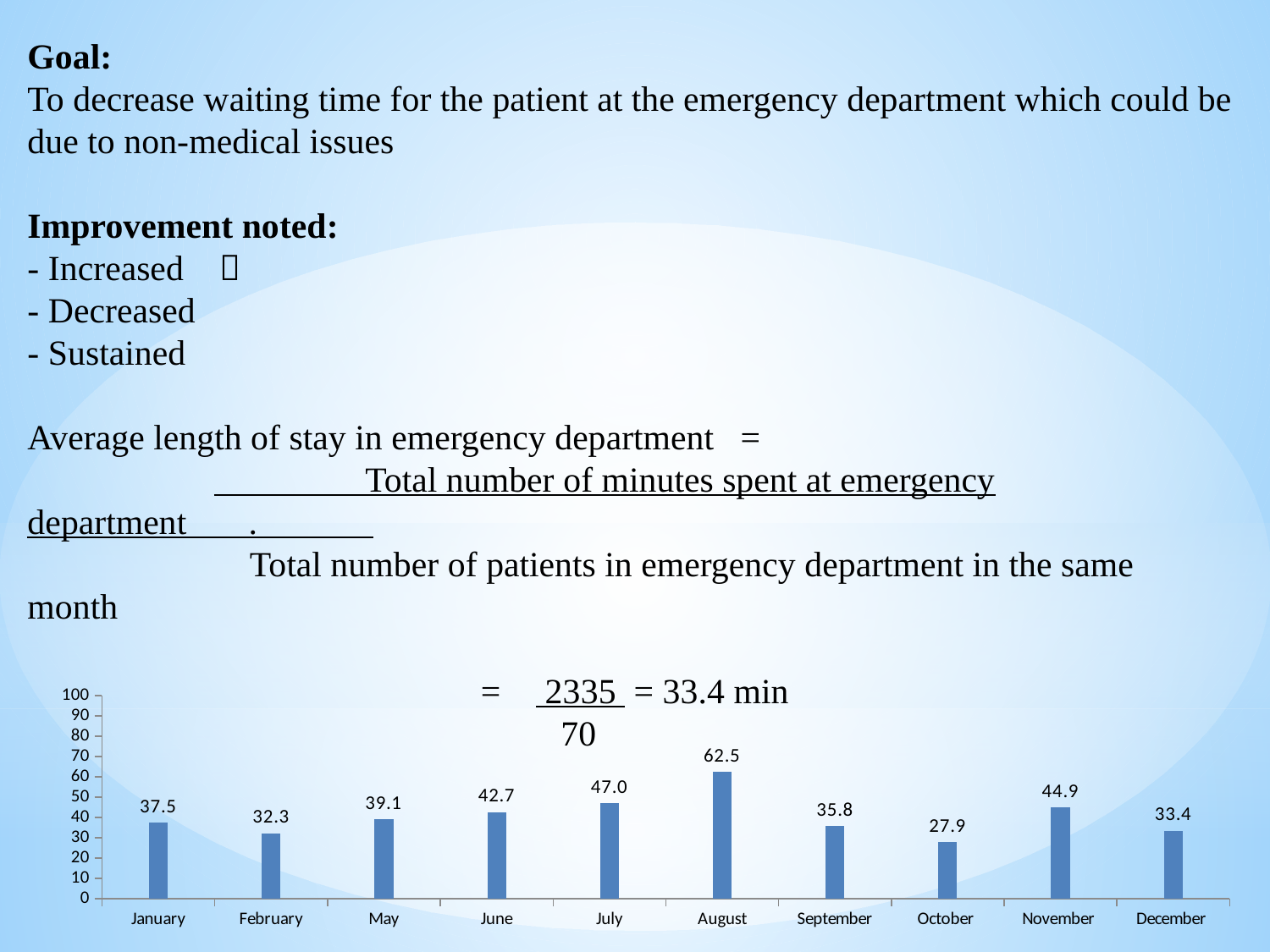
What is the value for August? 62.5 How many months are shown on the x axis of the chart? 10 What is the maximum value shown on the y axis of the chart? 100 What is the difference between the values for July and June? 4.3 What is the value for February? 32.3 Which month has the highest value? August Which is larger, the value for November or the value for May? November Is the value for August greater or less than 50? greater What is the difference between the values for August and October? 34.6 What kind of chart is shown on the slide? bar chart What is the value for October? 27.9 Which month has the lowest value? October